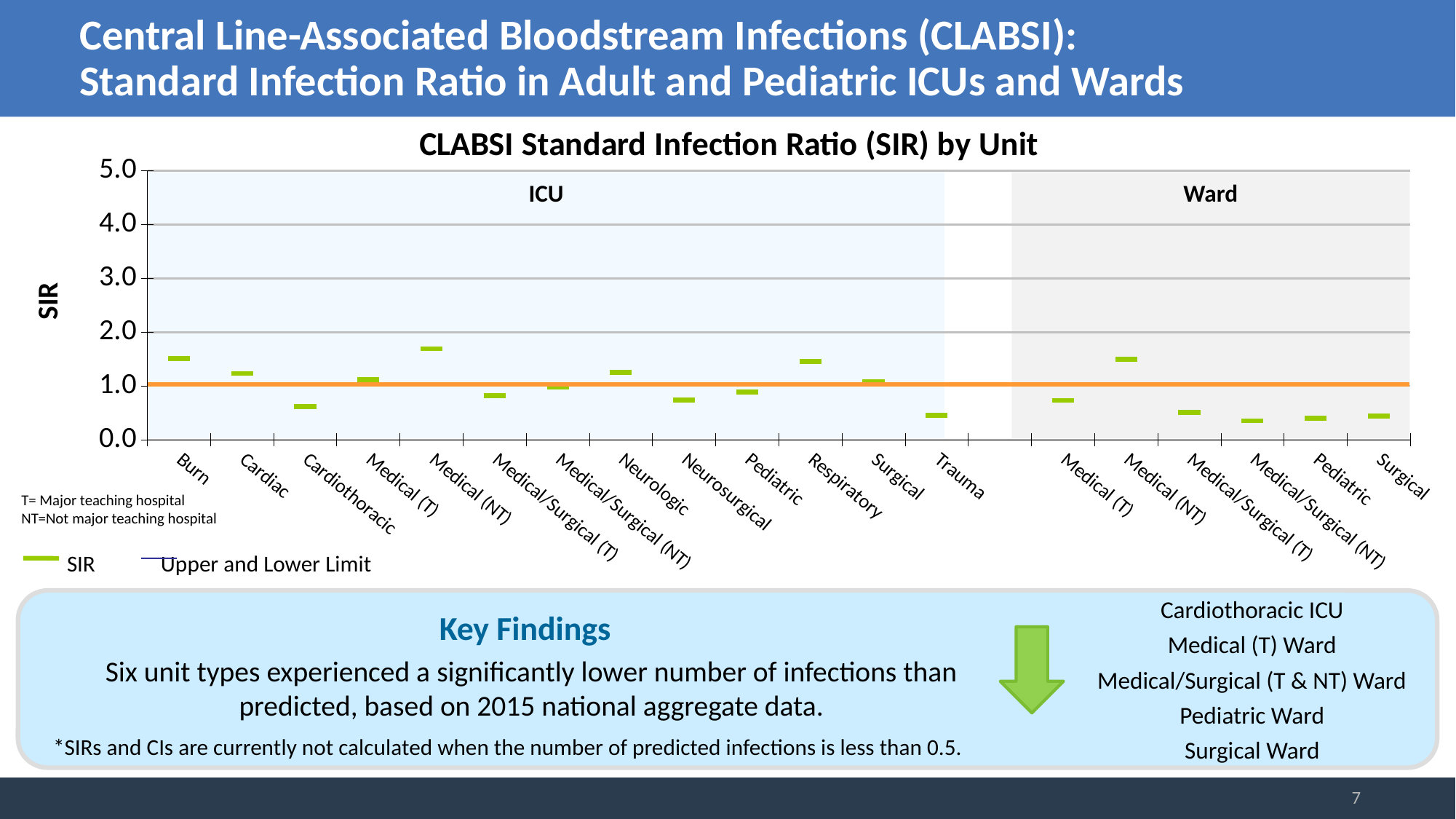
What is the title of the chart? CLABSI Standard Infection Ratio (SIR) by Unit How many series does the chart legend list? 2 Is the SIR value for the Cardiothoracic ICU greater or less than 1.0? less How many unit categories are in the Ward section of the chart? 6 How many unit categories are in the ICU section of the chart? 13 Is the SIR value for the Burn ICU greater or less than 1.0? greater Is the SIR value for the Trauma ICU greater or less than 1.0? less What are the two entries in the chart legend? SIR; Upper and Lower Limit Which has the larger SIR value, the Burn ICU or the Cardiothoracic ICU? Burn ICU Which unit has the highest SIR value on the chart? Medical (NT) ICU How many unit categories are plotted on the x axis in total? 19